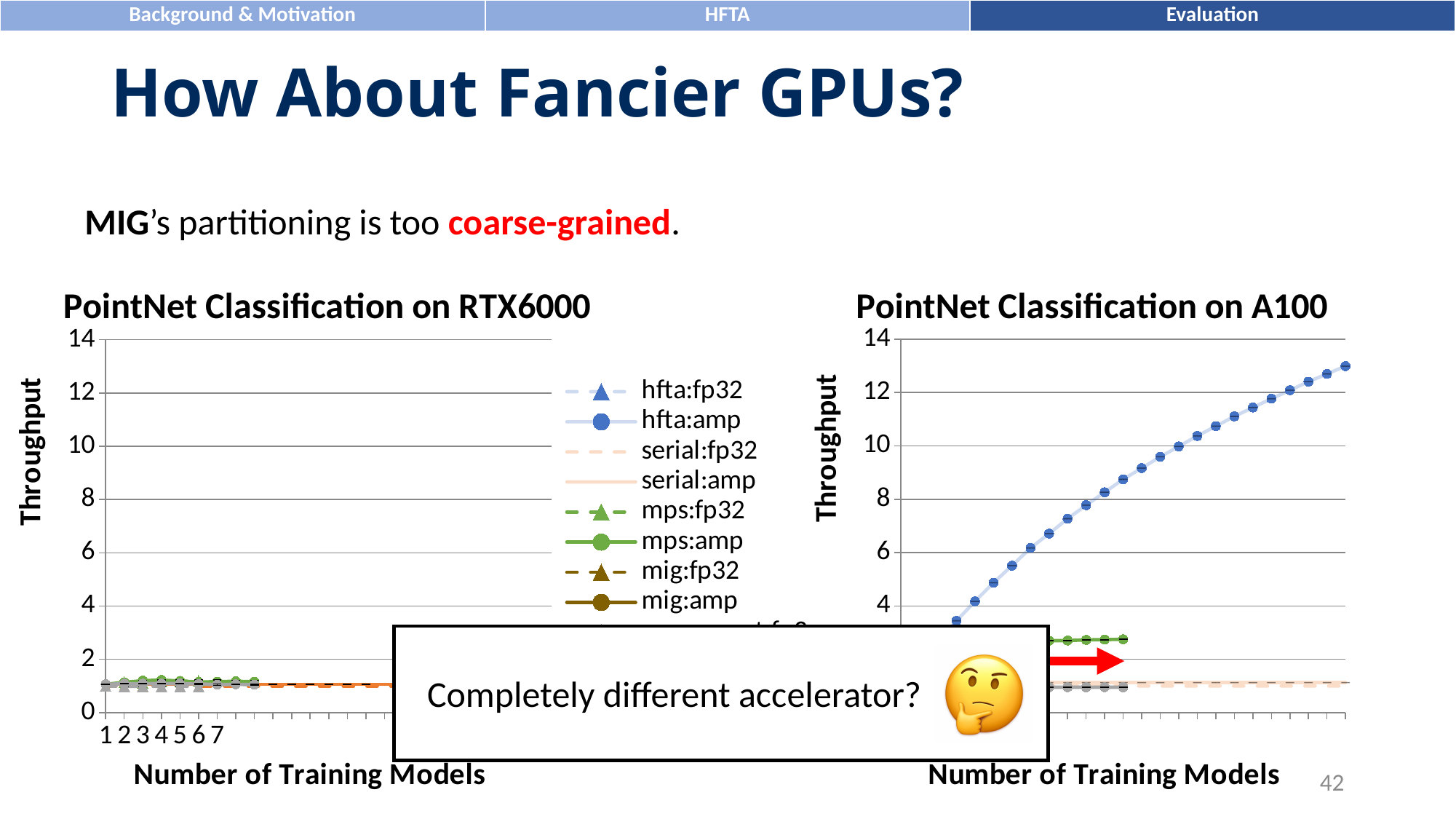
In the 'PointNet Classification on RTX6000' chart, does the mps:amp throughput rise sharply or stay roughly flat as the number of training models increases? roughly flat In the 'PointNet Classification on A100' chart, does the hfta:amp throughput rise or fall as the number of training models increases? rise What is the highest tick value shown on the y axis of the 'PointNet Classification on A100' chart? 14 What kind of chart is the 'PointNet Classification on A100' chart? line chart In the 'PointNet Classification on A100' chart, which series is plotted in blue with circle markers? hfta:amp In the 'PointNet Classification on A100' chart, is the highest hfta:amp throughput value greater or less than 12? greater What is the y-axis label of the 'PointNet Classification on RTX6000' chart? Throughput In the 'PointNet Classification on RTX6000' chart, is the mps:amp throughput greater or less than 2? less In the 'PointNet Classification on A100' chart, is the mps:amp throughput greater or less than 4? less In the 'PointNet Classification on A100' chart, which series reaches a higher throughput at its rightmost point, hfta:amp or mps:amp? hfta:amp